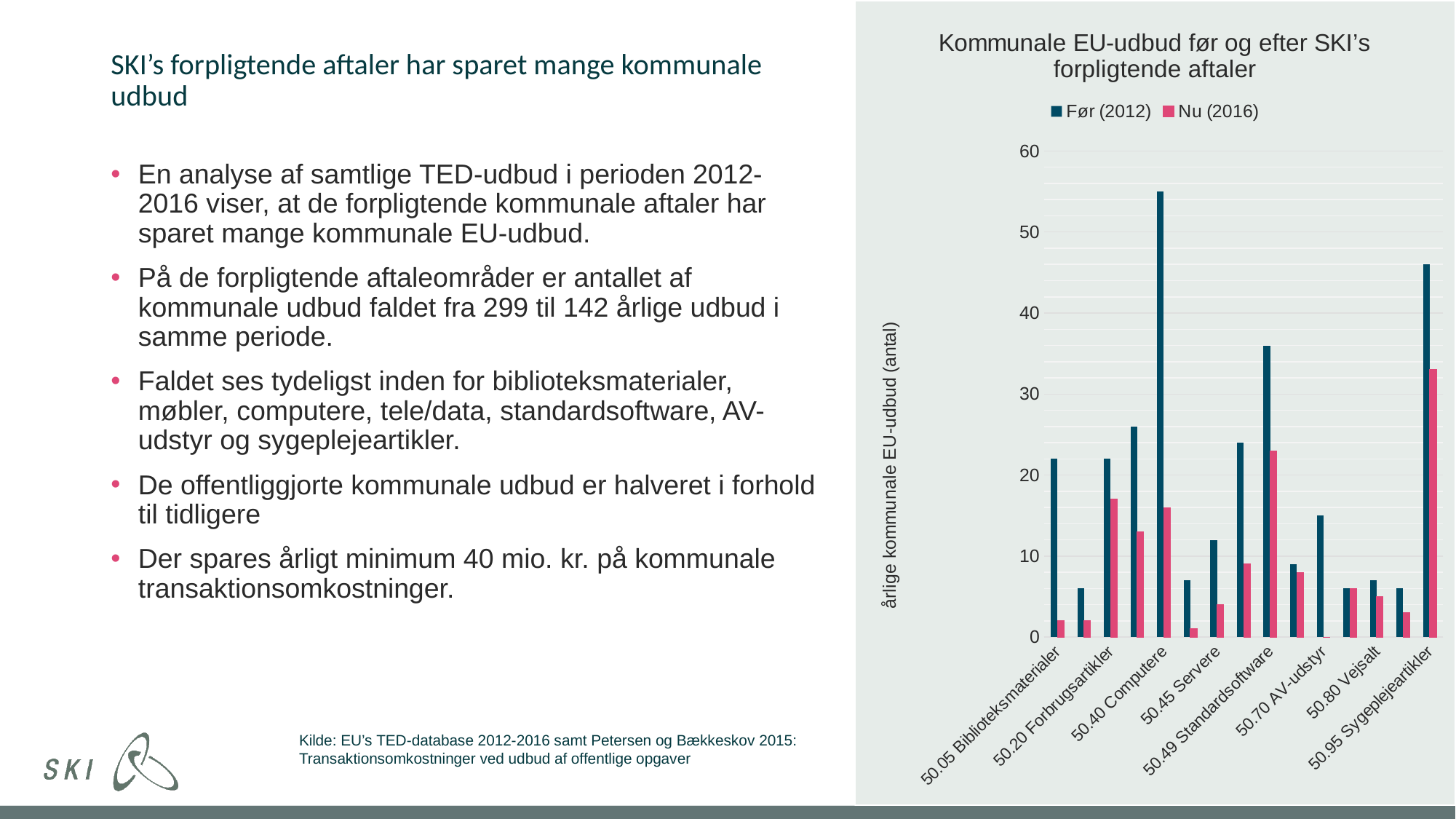
What kind of chart is shown on the slide? Bar chart What are the two series named in the chart legend? Før (2012) and Nu (2016) What is the title of the chart's vertical axis? årlige kommunale EU-udbud (antal) Is the Nu (2016) value for 50.95 Sygeplejeartikler greater or less than 30? greater For 50.40 Computere, which is larger: the Før (2012) value or the Nu (2016) value? Før (2012) Is the Før (2012) value for 50.49 Standardsoftware greater or less than 30? greater How many series does the chart legend list? 2 Is the Før (2012) value for 50.40 Computere greater or less than 50? greater Which labelled category has the highest Før (2012) value? 50.40 Computere Which labelled category has the highest Nu (2016) value? 50.95 Sygeplejeartikler For 50.45 Servere, which is larger: the Før (2012) value or the Nu (2016) value? Før (2012)